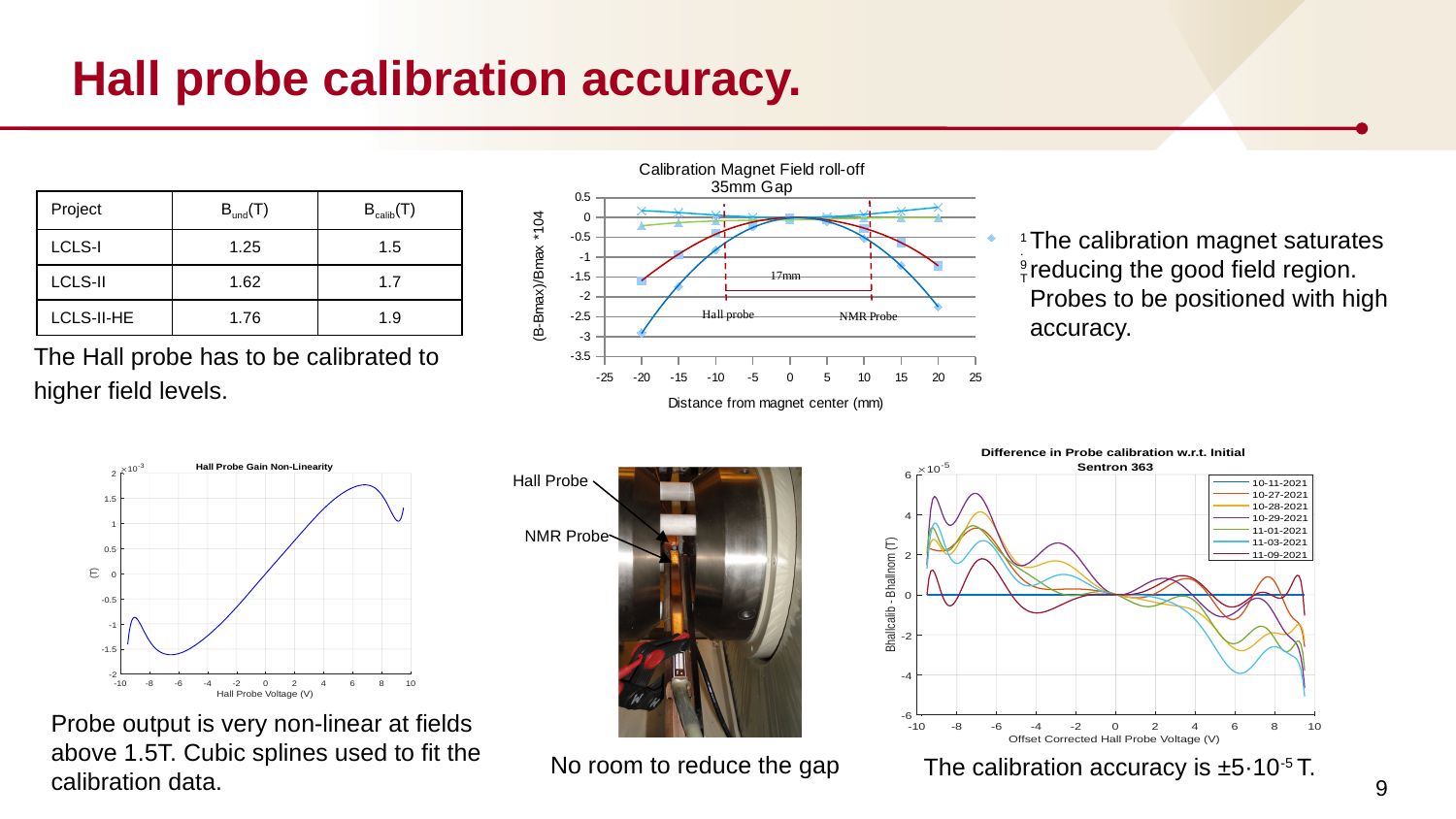
In the 'Calibration Magnet Field roll-off 35mm Gap' chart, is the value of the lowest (blue) curve at -20 mm greater or less than -2? less In the 'Calibration Magnet Field roll-off 35mm Gap' chart, what distance is marked between the two dashed vertical lines? 17mm In the 'Hall Probe Gain Non-Linearity' chart, does the curve rise or fall between -6 V and 6 V? rise What kind of chart is the 'Difference in Probe calibration w.r.t. Initial Sentron 363' chart? line chart In the 'Hall Probe Gain Non-Linearity' chart, is the peak value of the curve near 7 V greater or less than 1 (×10^-3)? greater What kind of chart is the 'Hall Probe Gain Non-Linearity' chart? line chart In the 'Calibration Magnet Field roll-off 35mm Gap' chart, what is the x-axis title? Distance from magnet center (mm) In the 'Difference in Probe calibration w.r.t. Initial Sentron 363' chart, which legend entry is listed first? 10-11-2021 What kind of chart is the 'Calibration Magnet Field roll-off 35mm Gap' chart? line chart How many series does the legend of the 'Difference in Probe calibration w.r.t. Initial Sentron 363' chart list? 7